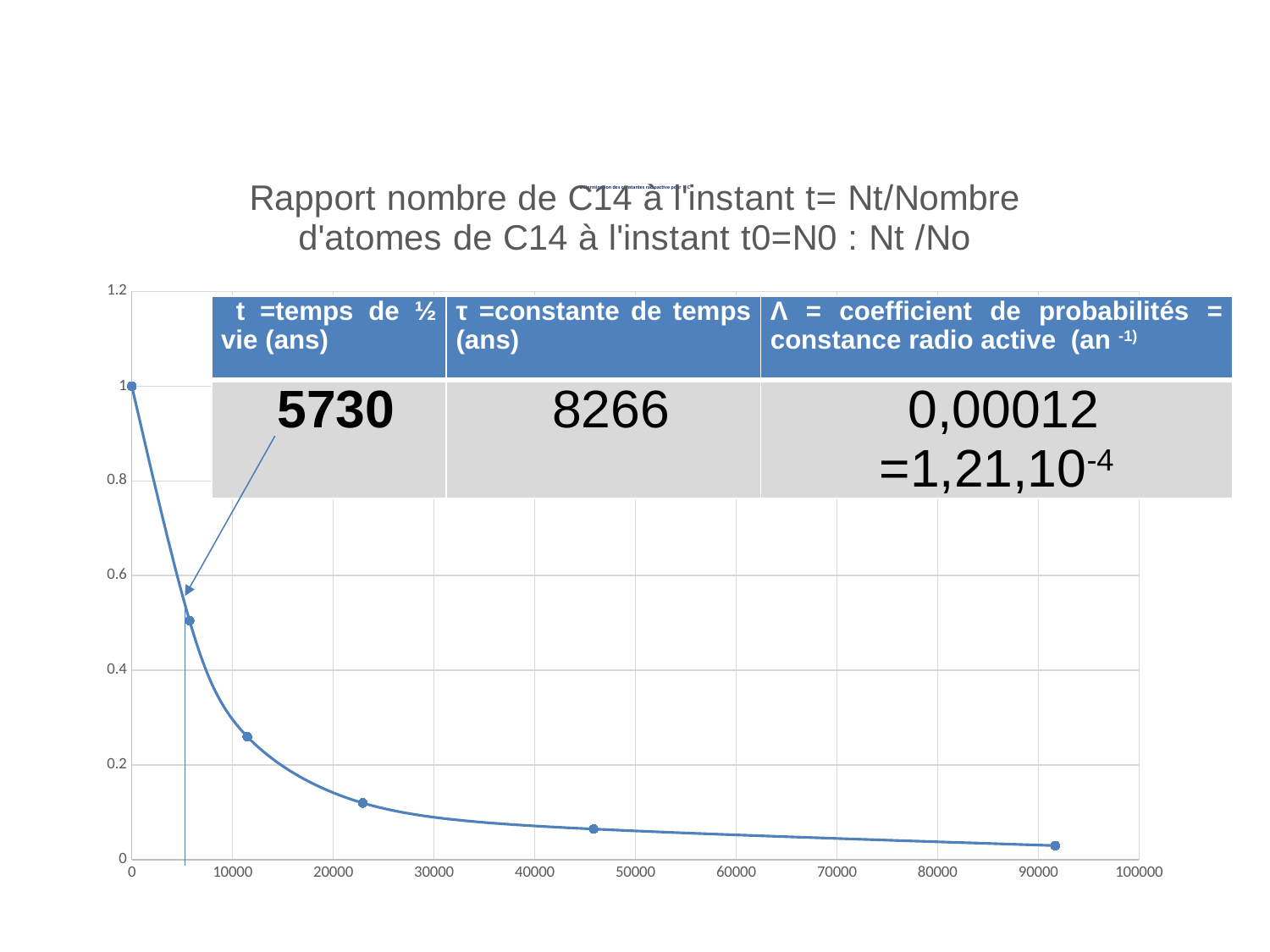
Is the value of the second data point (near x = 5000) greater or less than 0.4? greater What kind of chart is shown on the slide? line chart Is the value of the data point near x = 10000 greater or less than 0.2? greater How many data points are plotted on the curve? 6 Do the plotted values rise or fall as the x axis increases? fall Is the value of the data point near x = 50000 greater or less than 0.2? less What is the value of the first data point, at x = 0? 1 At which x value is the plotted value highest? 0 Which is larger: the value of the point near x = 10000 or the value of the point near x = 50000? the point near x = 10000 What is the highest tick value shown on the x axis? 100000